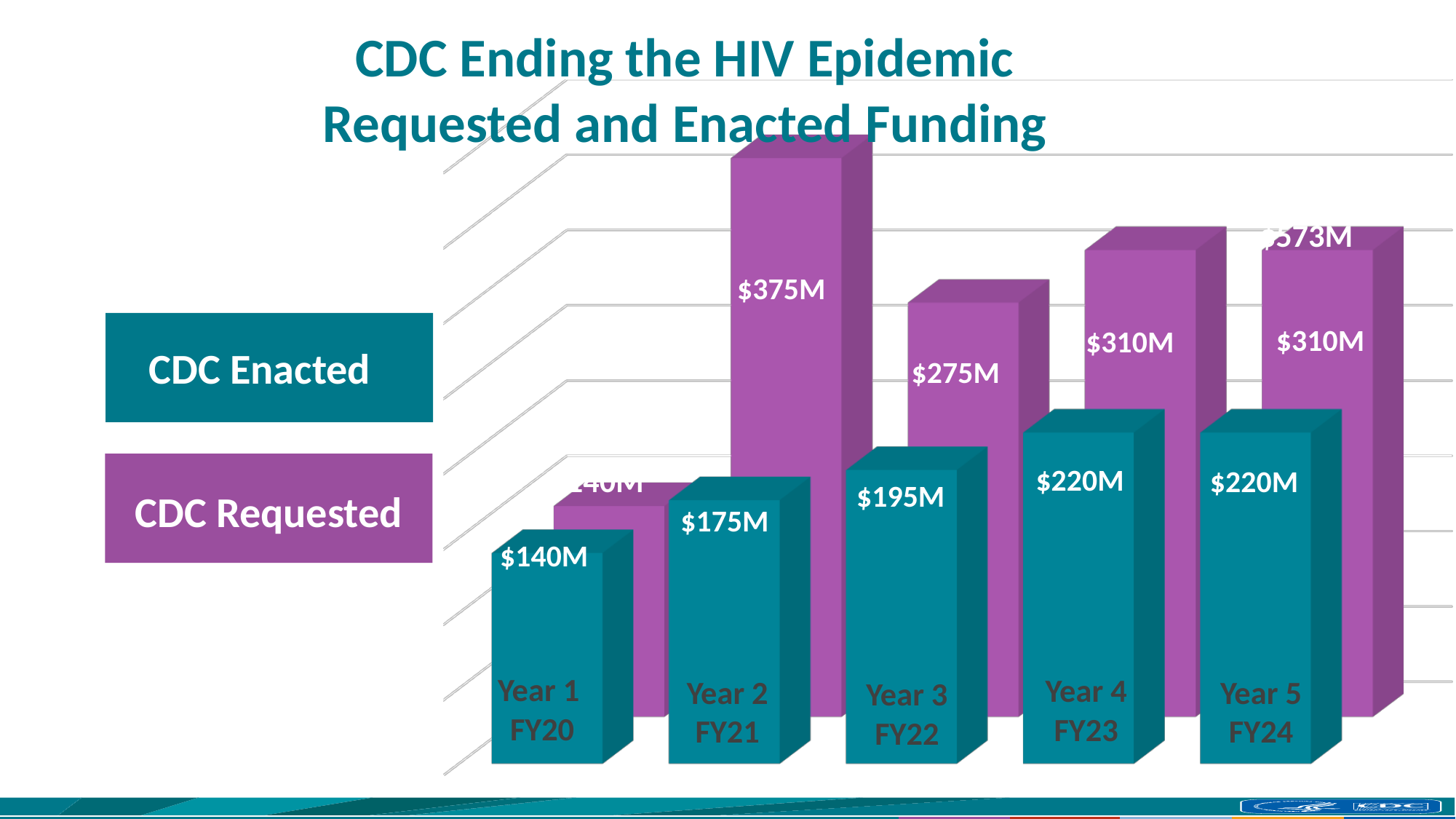
Which is larger: CDC Requested in Year 3 FY22 or CDC Enacted in Year 4 FY23? CDC Requested in Year 3 FY22 What is the CDC Requested value for Year 3 FY22? $275M What kind of chart is shown on the slide? Bar chart What is the CDC Enacted value for Year 2 FY21? $175M Do the CDC Enacted values generally rise or fall from Year 1 FY20 to Year 5 FY24? Rise What is the CDC Requested value for Year 4 FY23? $310M In which year is the CDC Enacted value lowest? Year 1 FY20 What is the difference between CDC Requested and CDC Enacted in Year 2 FY21? $200M What is the CDC Enacted value for Year 4 FY23? $220M How many years (categories) are shown along the x axis? 5 How many series does the legend list? 2 In which year is the CDC Requested value highest? Year 2 FY21